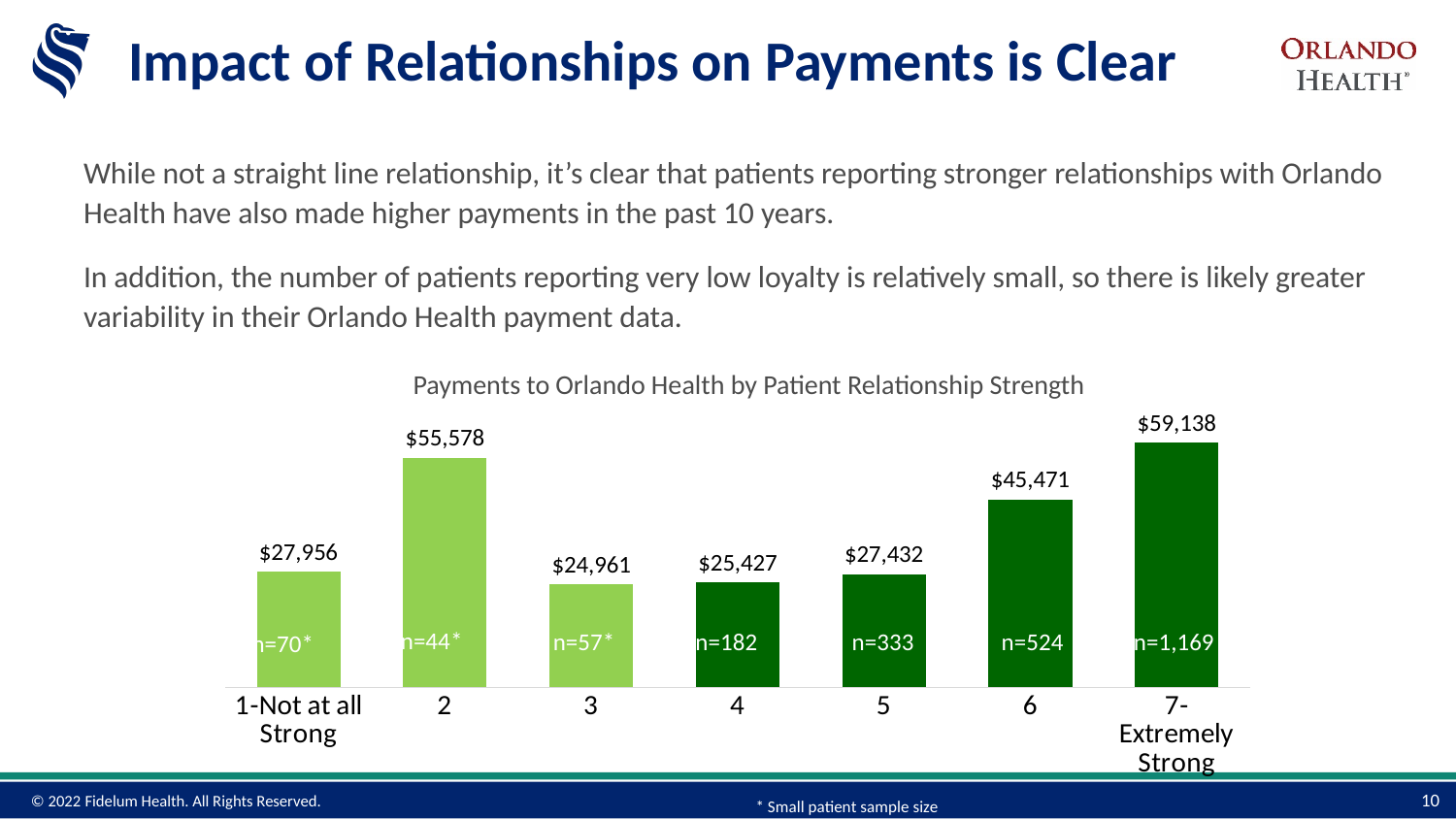
Which category has the highest payment value? 7-Extremely Strong Which category has the lowest payment value? 3 What is the payment value for relationship strength 5? $27,432 What is the sample size (n) shown for category 4? n=182 What is the payment value for the '7-Extremely Strong' category? $59,138 What is the difference between the payment values for category 6 and category 5? $18,039 How many categories are shown on the x axis? 7 What is the difference between the payment values for '7-Extremely Strong' and '1-Not at all Strong'? $31,182 What is the payment value for relationship strength 2? $55,578 What kind of chart is shown on the slide? Bar chart Which has a larger payment value, category 2 or category 6? 2 What is the title of the chart? Payments to Orlando Health by Patient Relationship Strength